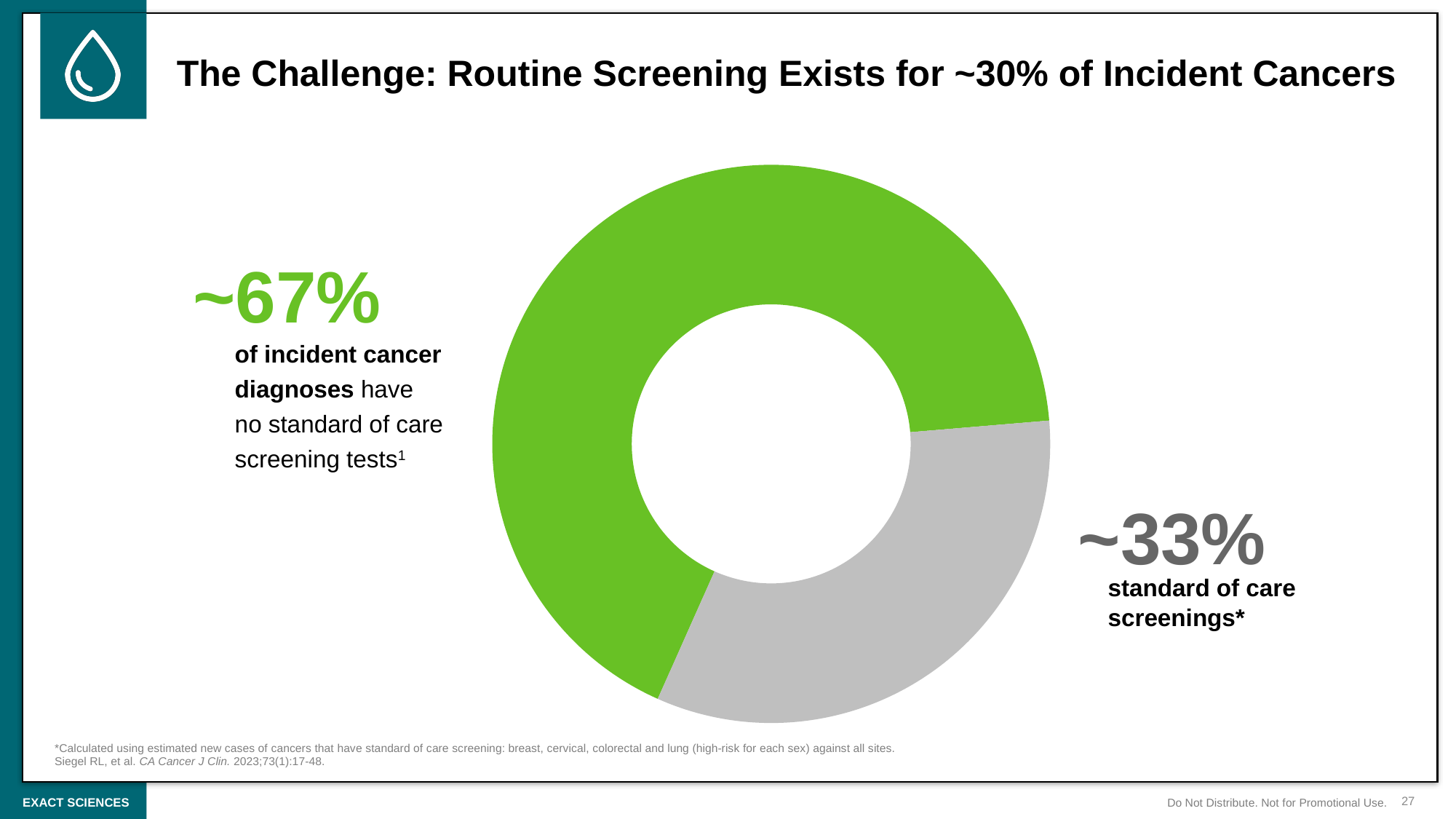
Which slice of the donut chart is the smallest? Standard of care screenings (~33%) Is the share for standard of care screenings greater or less than 50%? less What kind of chart is shown on the slide? Pie chart (donut) What colour is the slice representing standard of care screenings? Grey Which slice of the donut chart is the largest? No standard of care screening tests (~67%) What share is labelled for standard of care screenings on the chart? ~33% What colour is the slice representing incident cancer diagnoses with no standard of care screening tests? Green How many slices does the donut chart have? 2 Is the share of incident cancer diagnoses with no standard of care screening tests greater or less than 50%? greater Which slice is larger: the one for no standard of care screening tests or the one for standard of care screenings? No standard of care screening tests What share of incident cancer diagnoses have no standard of care screening tests, as labelled on the chart? ~67%